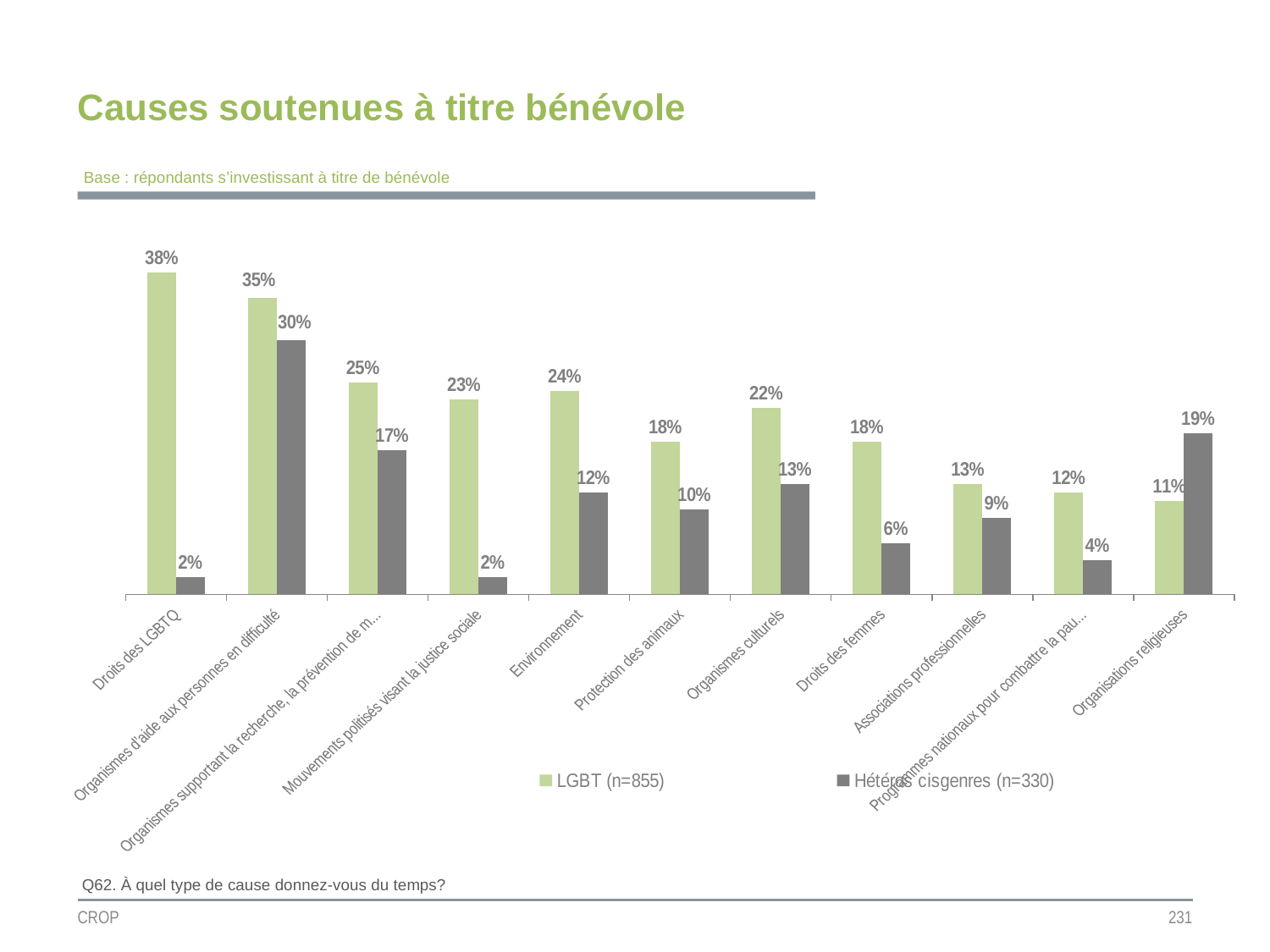
Which category has the highest value for Hétéros cisgenres (n=330)? Organismes d'aide aux personnes en difficulté What is the value for Hétéros cisgenres (n=330) for Organisations religieuses? 19% Which category has the lowest value for LGBT (n=855)? Organisations religieuses How many categories are shown on the x axis? 11 What kind of chart is shown on the slide? Bar chart What is the title of the chart on the slide? Causes soutenues à titre bénévole What is the value for Hétéros cisgenres (n=330) for Environnement? 12% What is the value for LGBT (n=855) for Droits des LGBTQ? 38% How many series does the legend list? 2 What is the difference between the LGBT (n=855) and Hétéros cisgenres (n=330) values for Droits des femmes? 12% For Organisations religieuses, which series has the larger value, LGBT (n=855) or Hétéros cisgenres (n=330)? Hétéros cisgenres (n=330) Which category has the highest value for LGBT (n=855)? Droits des LGBTQ